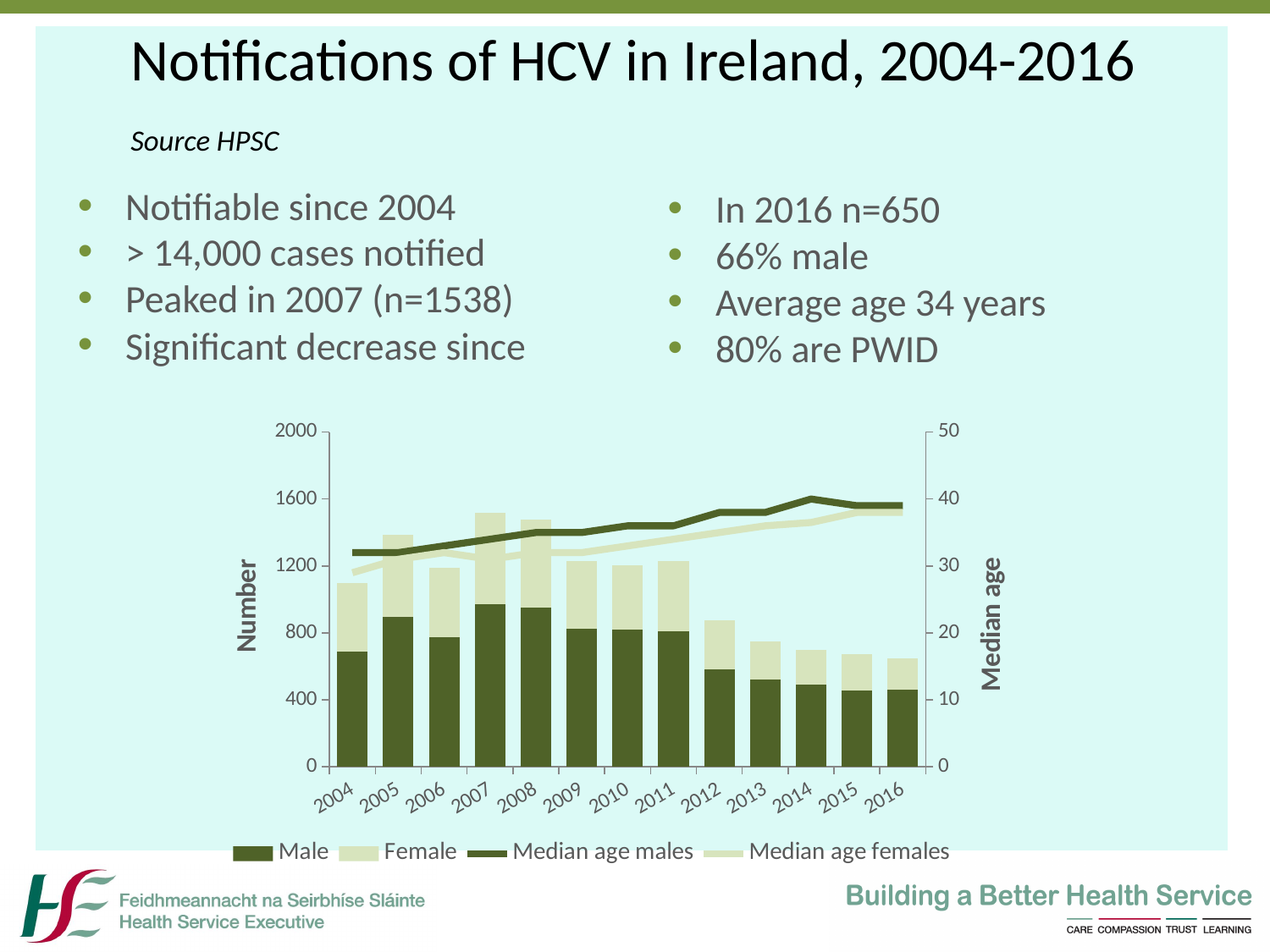
Is the total stacked bar for 2016 greater or less than 800? less In 2010, which line is higher, Median age males or Median age females? Median age males Does the Median age males line generally rise or fall from 2004 to 2016? Rise How many series does the chart legend list? 4 Is the Median age males value for 2014 greater or less than 30? greater Which year has the tallest stacked bar (highest total notifications)? 2007 What is the title of the right-hand vertical axis? Median age Which is larger, the Male value for 2007 or the Male value for 2016? 2007 Is the Male value for 2007 greater or less than 800? greater How many years are shown on the x axis of the chart? 13 What kind of chart is shown on the slide? A combined stacked bar and line chart